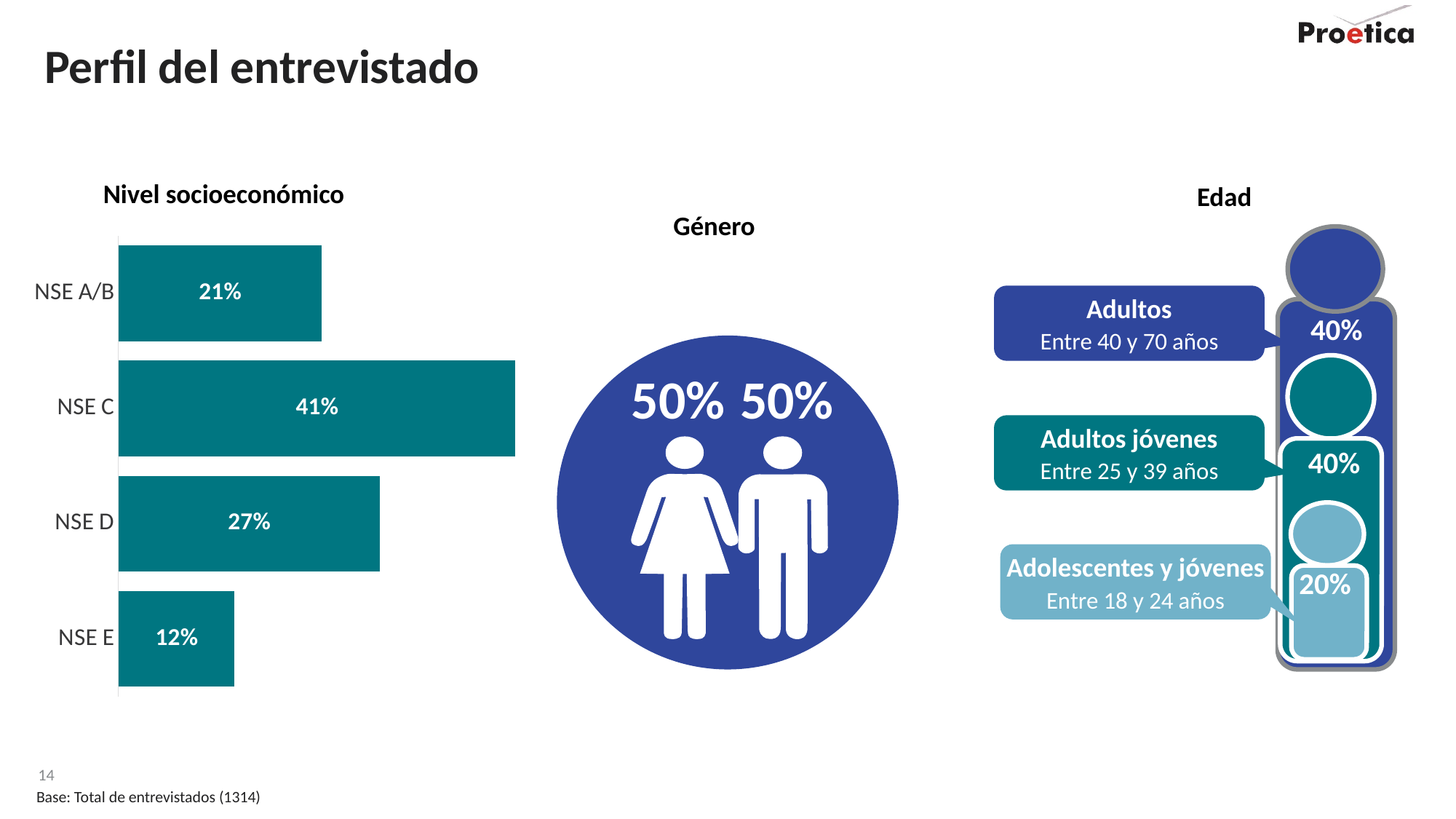
In the 'Nivel socioeconómico' chart, which category has the lowest value? NSE E What kind of chart is the 'Nivel socioeconómico' chart? Bar chart In the 'Edad' graphic, what is the share for 'Adolescentes y jóvenes' (Entre 18 y 24 años)? 20% In the 'Nivel socioeconómico' chart, what is the value for NSE A/B? 21% How many categories does the 'Nivel socioeconómico' chart show? 4 In the 'Nivel socioeconómico' chart, which is larger, NSE A/B or NSE D? NSE D In the 'Género' graphic, what percentage is shown for each gender? 50% In the 'Nivel socioeconómico' chart, which category has the highest value? NSE C In the 'Nivel socioeconómico' chart, what is the value for NSE E? 12% In the 'Nivel socioeconómico' chart, what is the difference between NSE C and NSE D? 14% In the 'Nivel socioeconómico' chart, what is the value for NSE C? 41% In the 'Edad' graphic, what is the share for 'Adultos' (Entre 40 y 70 años)? 40%